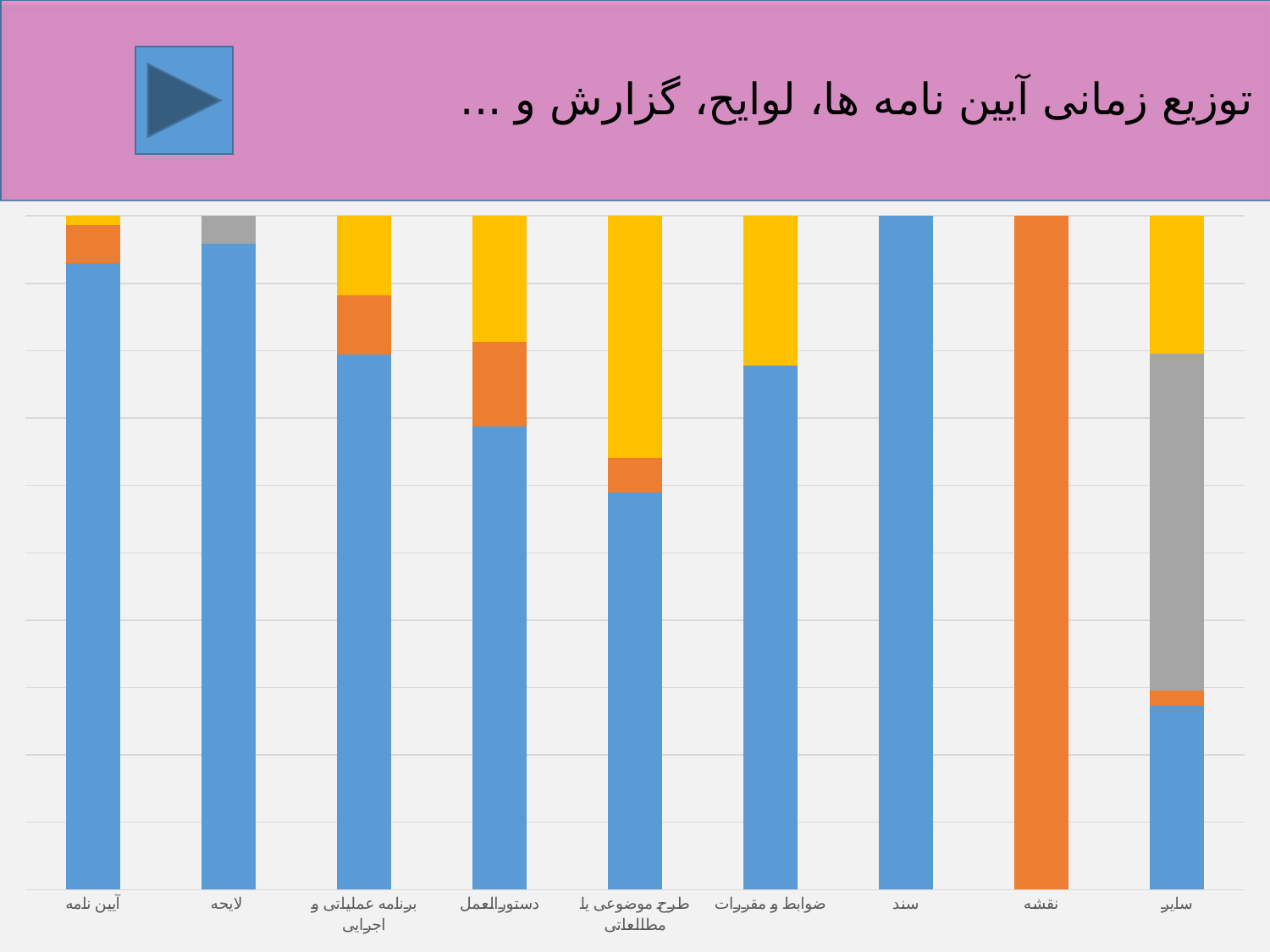
Which category has the smallest blue segment among bars that contain blue? سایر Which category's bar is made up entirely of the blue segment? سند Which category has the largest grey segment? سایر How many categories are shown along the x axis of the chart? 9 Is the blue segment larger for لایحه or for دستورالعمل? لایحه Which category has the largest yellow segment? طرح موضوعی یا مطالعاتی What is the title of the slide above the chart? توزیع زمانی آیین نامه ها، لوایح، گزارش و ... Which category is the first (rightmost) on the x axis? سایر Is the orange segment larger for دستورالعمل or for برنامه عملیاتی و اجرایی? دستورالعمل Which category's bar is made up entirely of the orange segment? نقشه What kind of chart is shown on the slide? Stacked bar chart Is the yellow segment larger for ضوابط و مقررات or for آیین نامه? ضوابط و مقررات